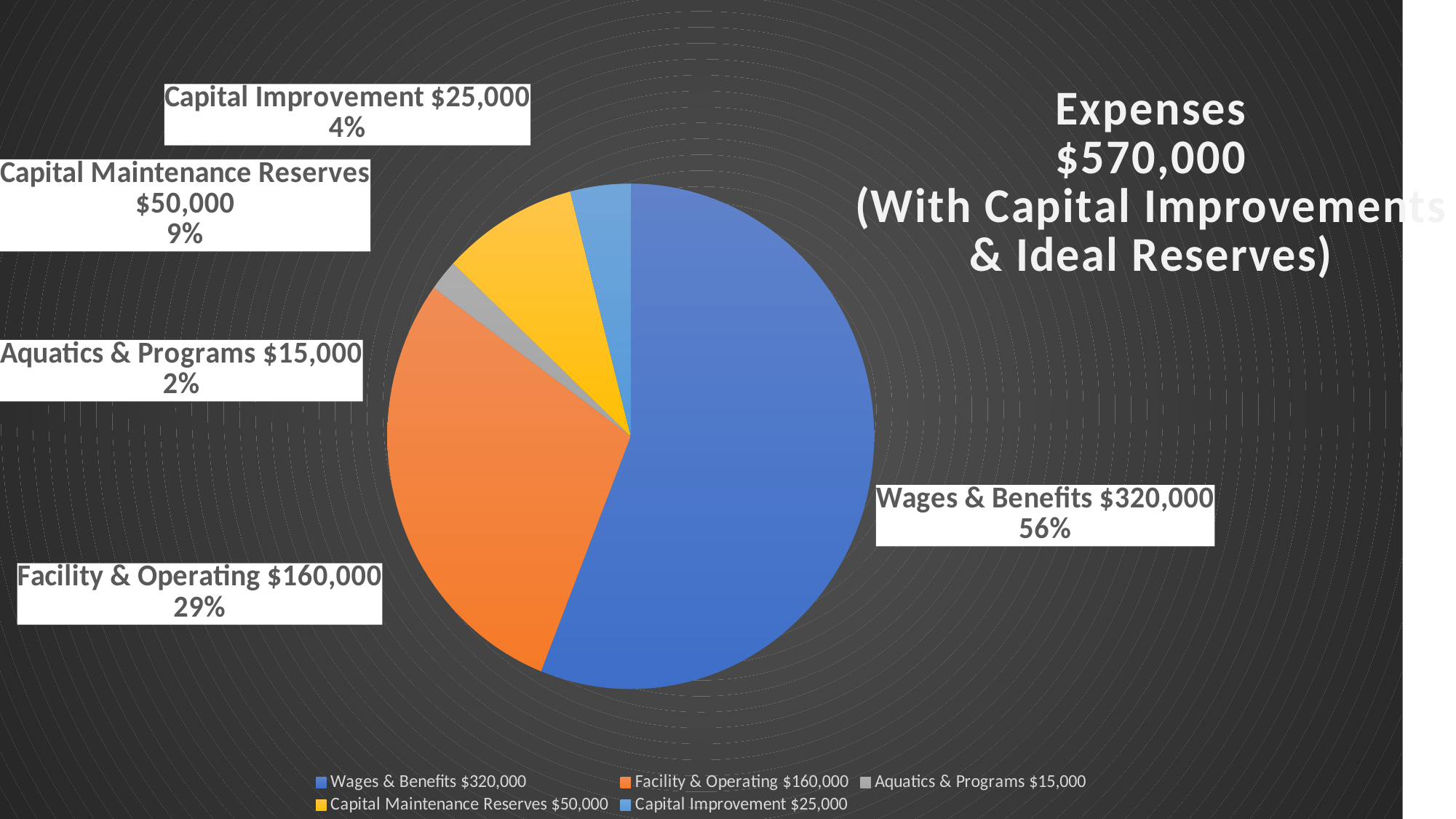
What kind of chart is shown on the slide? Pie chart Which category has the smallest slice of the pie? Aquatics & Programs How many categories are shown in the pie chart? 5 What total expenses amount is stated in the chart title? $570,000 What is the difference between Wages & Benefits and Facility & Operating? $160,000 Which category has the largest slice of the pie? Wages & Benefits What is the value for Capital Maintenance Reserves? $50,000 What colour is the Facility & Operating slice? Orange What is the value for Wages & Benefits? $320,000 What percentage share does Capital Improvement have? 4% Which is larger, Capital Maintenance Reserves or Capital Improvement? Capital Maintenance Reserves What percentage share does Facility & Operating have? 29%